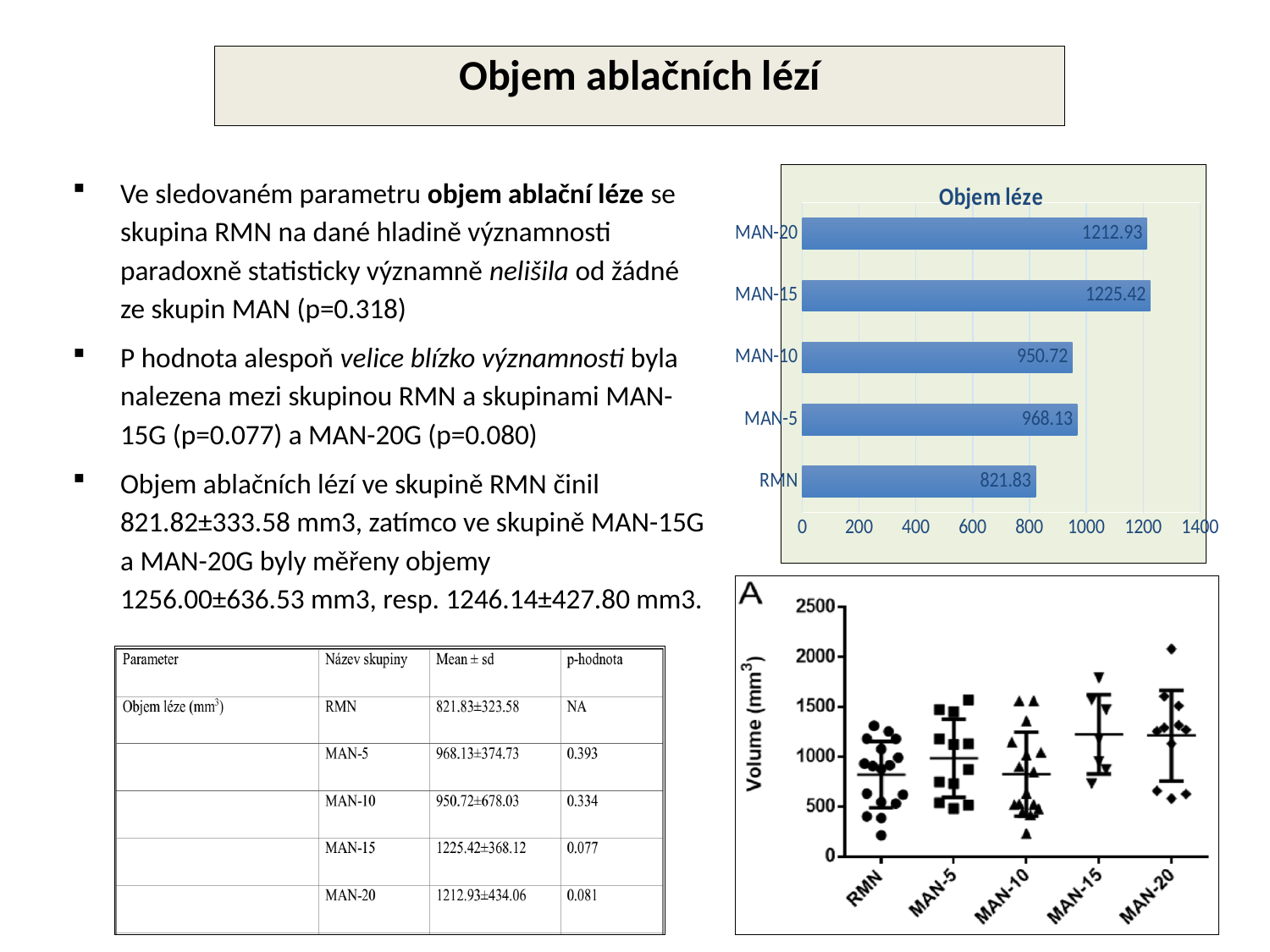
In the bar chart titled "Objem léze", what is the value for MAN-20? 1212.93 In the bar chart titled "Objem léze", what is the difference between the values for MAN-20 and RMN? 391.10 In the bar chart titled "Objem léze", what is the value for RMN? 821.83 In the bar chart titled "Objem léze", which category has the highest value? MAN-15 In the bar chart titled "Objem léze", is the value for RMN greater or less than 1000? less In the bar chart titled "Objem léze", which category has the lowest value? RMN In the bar chart titled "Objem léze", which is larger, the value for MAN-5 or the value for MAN-10? MAN-5 In the bar chart titled "Objem léze", how many categories are shown? 5 In the bar chart titled "Objem léze", what is the value for MAN-10? 950.72 In the bar chart titled "Objem léze", what is the difference between the values for MAN-15 and MAN-20? 12.49 In the chart labelled A at the bottom right, what is the label of the y axis? Volume (mm³) What kind of chart is the chart titled "Objem léze"? bar chart